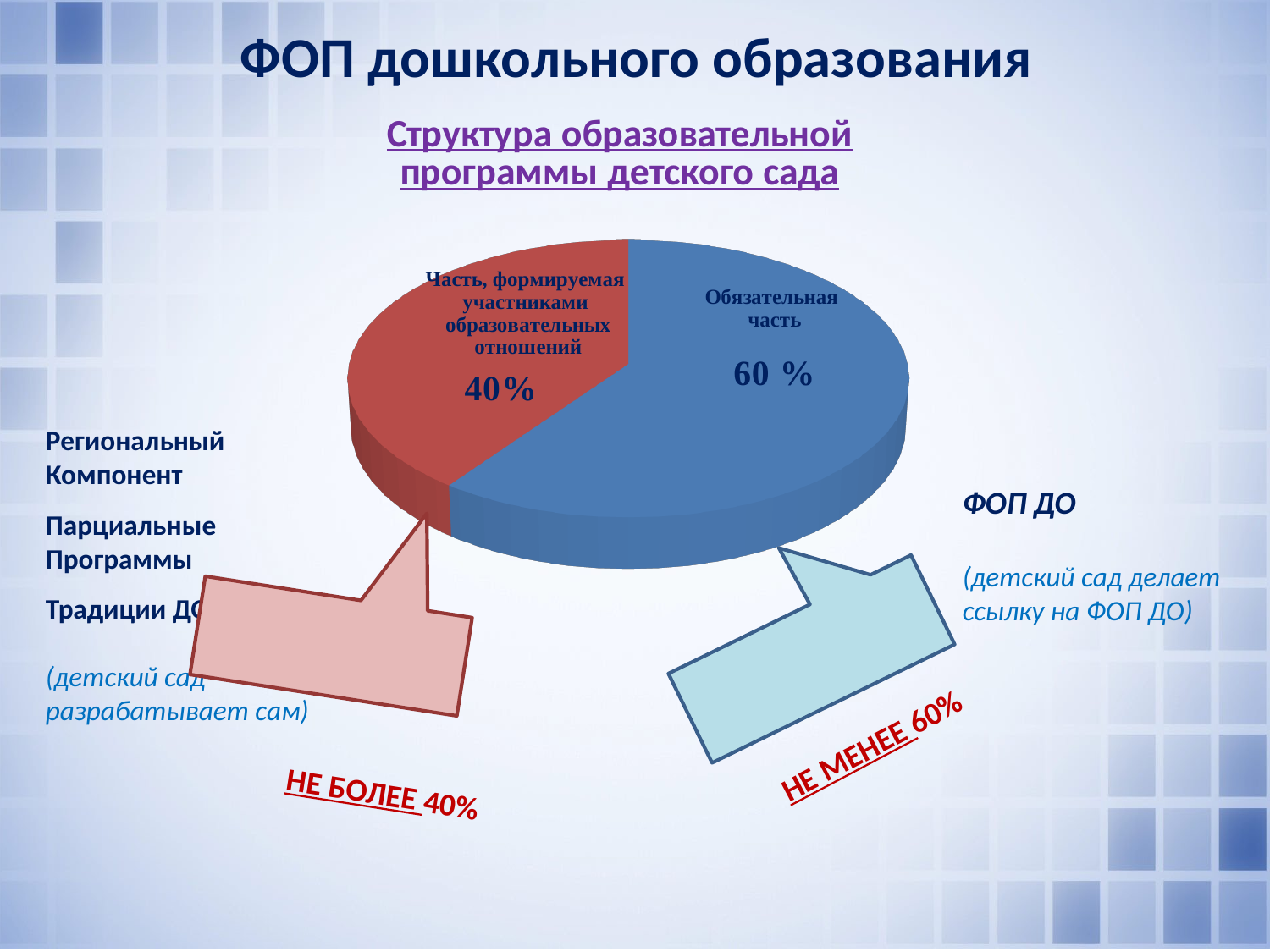
What is the title of the chart? Структура образовательной программы детского сада Which slice of the pie is the smallest? Часть, формируемая участниками образовательных отношений Is the share of "Обязательная часть" greater or less than 50%? greater How many slices does the pie chart have? 2 Which slice of the pie is the largest? Обязательная часть What share of the pie does "Обязательная часть" take? 60 % Is the share of "Часть, формируемая участниками образовательных отношений" greater or less than 50%? less Which is larger: "Обязательная часть" or "Часть, формируемая участниками образовательных отношений"? Обязательная часть What is the difference in percentage points between "Обязательная часть" and "Часть, формируемая участниками образовательных отношений"? 20 What colour is the "Обязательная часть" slice? blue What type of chart is shown on the slide? pie chart What share of the pie does "Часть, формируемая участниками образовательных отношений" take? 40%